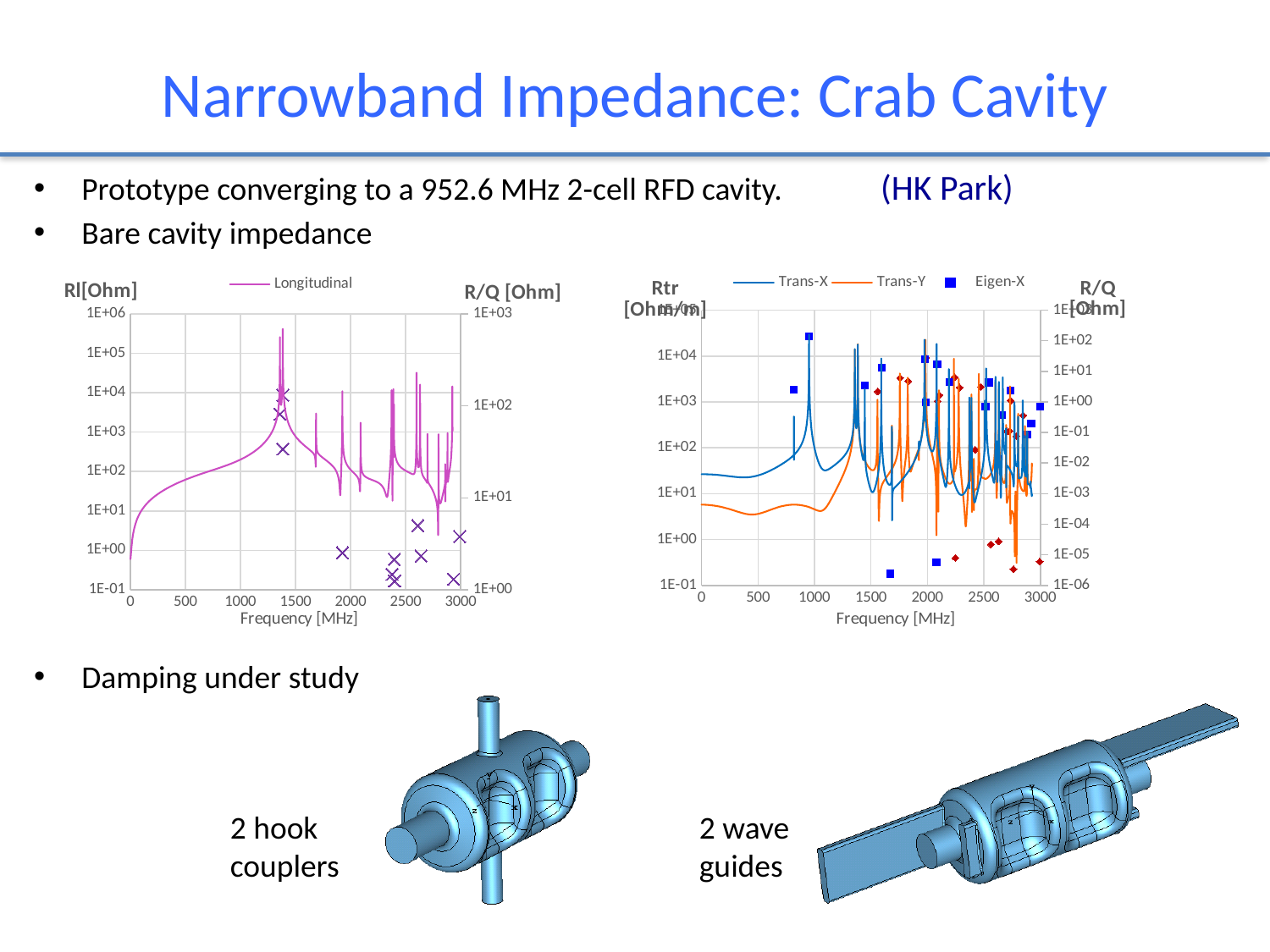
How many series does the legend of the left chart list? 1 In the right chart, is the Trans-Y value at 0 MHz greater or less than 1E+01? less What kind of chart is the left chart (Longitudinal)? line chart In the right chart, at 0 MHz, which is larger: Trans-X or Trans-Y? Trans-X In the left chart, does the Longitudinal curve rise or fall between 0 and 1000 MHz? rise How many tick labels are shown on the x axis of the right chart? 7 In the right chart, is the Trans-X value at 0 MHz greater or less than 1E+01? greater What is the x-axis title of the left chart? Frequency [MHz] In the right chart, is the Trans-X peak near 1000 MHz greater or less than 1E+04? greater How many series does the legend of the right chart list? 3 In the right chart, what are the three legend entries? Trans-X, Trans-Y, Eigen-X